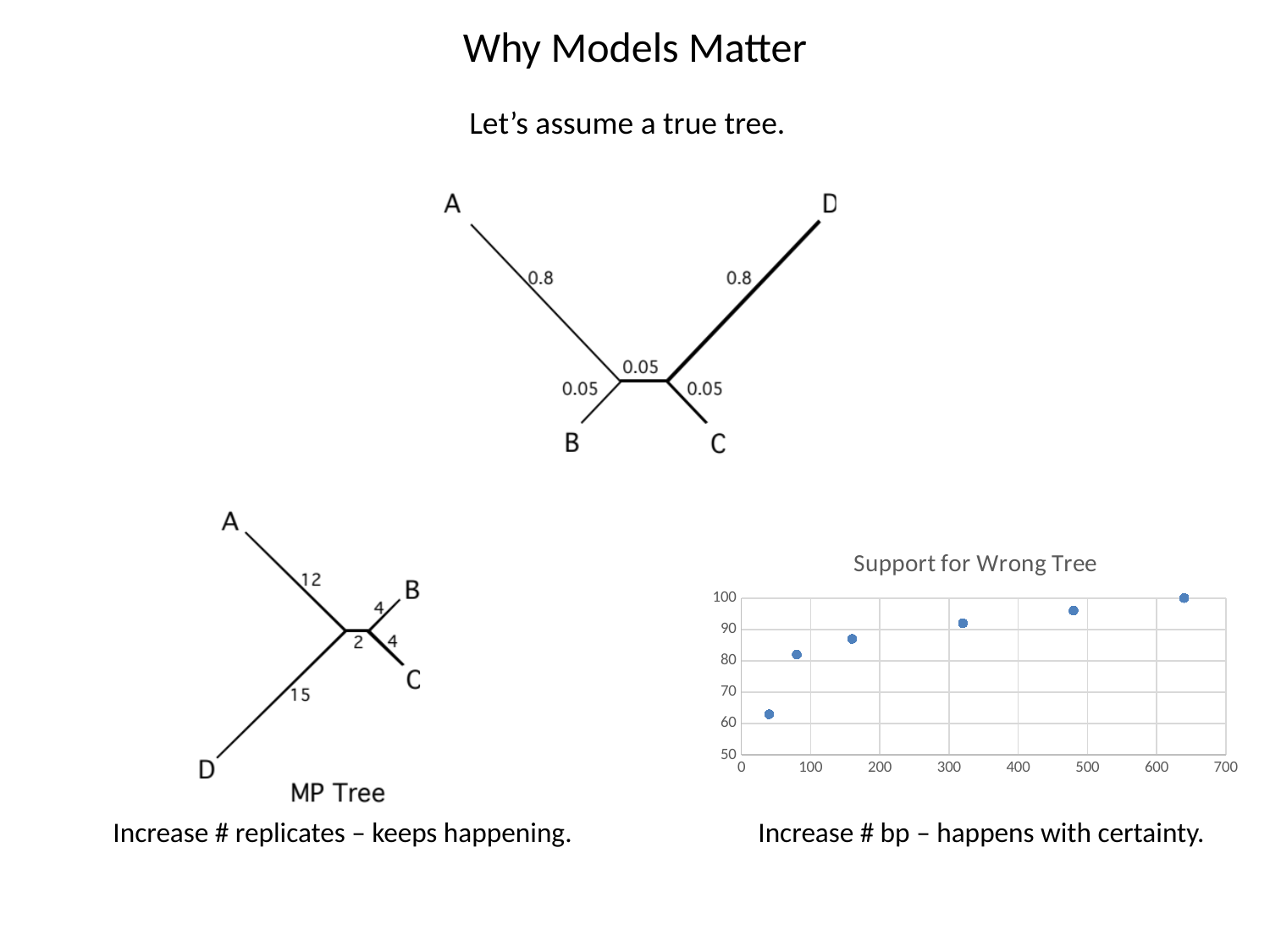
In the "Support for Wrong Tree" chart, is the value of the rightmost point greater or less than 90? greater In the "Support for Wrong Tree" chart, is the value of the point just below x = 200 greater or less than 90? less How many data points are plotted in the "Support for Wrong Tree" chart? 6 In the "Support for Wrong Tree" chart, is the value of the point just above x = 300 greater or less than 90? greater In the "Support for Wrong Tree" chart, which point has the lowest value: the leftmost or the rightmost? the leftmost In the "Support for Wrong Tree" chart, which point has the highest value: the leftmost or the rightmost? the rightmost What is the highest value shown on the y-axis of the "Support for Wrong Tree" chart? 100 What kind of chart is the "Support for Wrong Tree" chart? scatter chart What is the title of the chart on the slide? Support for Wrong Tree In the "Support for Wrong Tree" chart, do the values rise or fall as the x-axis value increases? rise